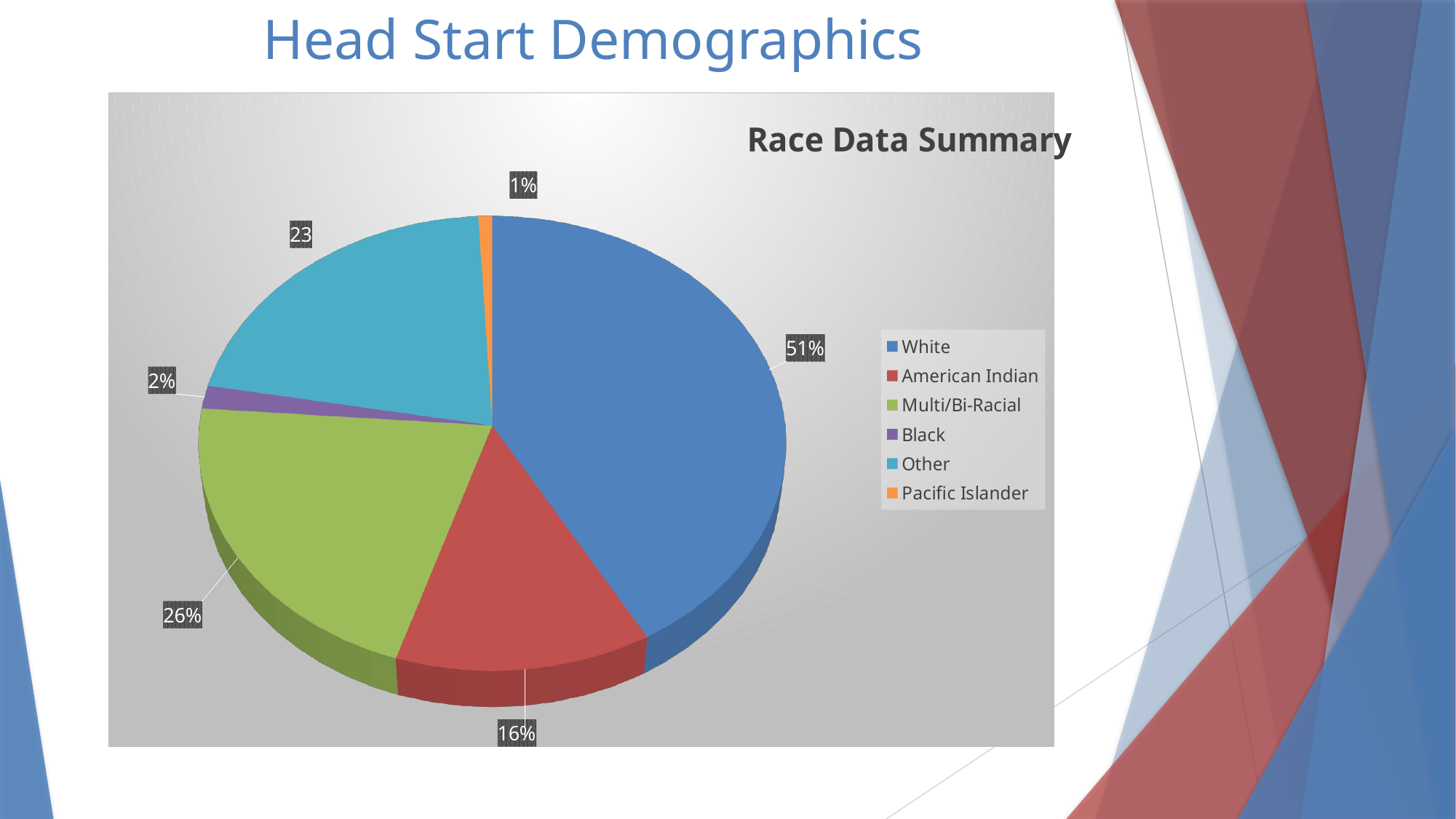
What is the title of the chart? Race Data Summary Which category has the largest slice of the pie? White Which category has the smallest slice of the pie? Pacific Islander What is the value shown for Pacific Islander? 1% What is the value shown for American Indian? 16% What is the difference between the White and Multi/Bi-Racial percentages? 25% What is the value shown for Black? 2% Which is larger, the slice for American Indian or the slice for Multi/Bi-Racial? Multi/Bi-Racial What is the value shown for Multi/Bi-Racial? 26% What type of chart is shown on the slide? pie chart What share of the pie does White represent? 51% How many categories does the legend list? 6